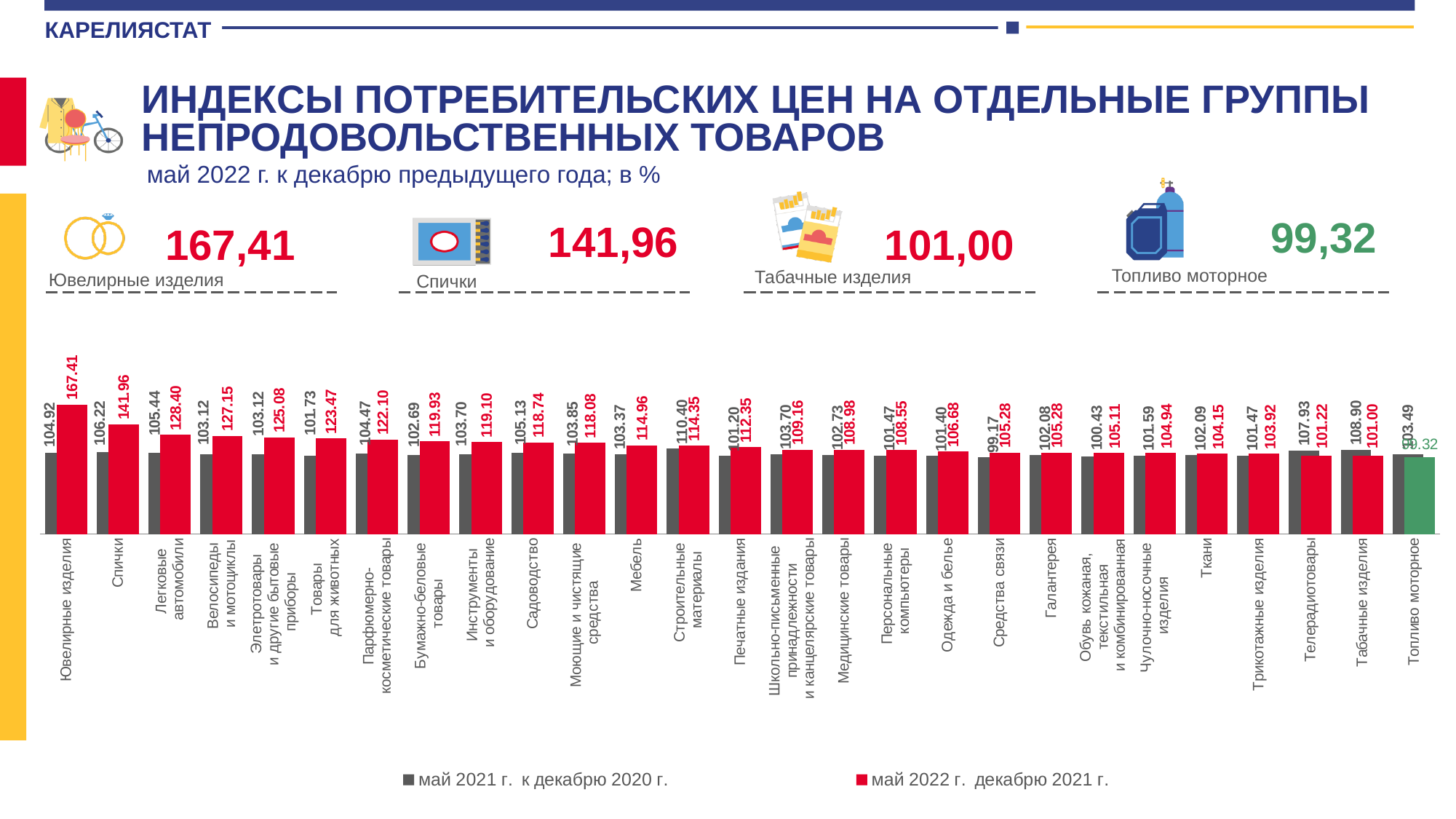
How many series does the legend list? 2 What kind of chart is shown on the slide? Bar chart How many product categories are shown on the x axis of the chart? 27 What is the value for Мебель in the series май 2022 г. к декабрю 2021 г.? 114.96 Which category has the highest value in the series май 2022 г. к декабрю 2021 г.? Ювелирные изделия Which category has the lowest value in the series май 2021 г. к декабрю 2020 г.? Средства связи What is the value for Ювелирные изделия in the series май 2022 г. к декабрю 2021 г.? 167.41 Which category has the lowest value in the series май 2022 г. к декабрю 2021 г.? Топливо моторное What is the value for Строительные материалы in the series май 2021 г. к декабрю 2020 г.? 110.40 Which is larger for Табачные изделия: the май 2021 г. к декабрю 2020 г. value or the май 2022 г. к декабрю 2021 г. value? май 2021 г. к декабрю 2020 г. Which bar in the series май 2022 г. к декабрю 2021 г. is coloured green instead of red? Топливо моторное What is the difference between the two series values for Спички (141.96 minus 106.22)? 35.74